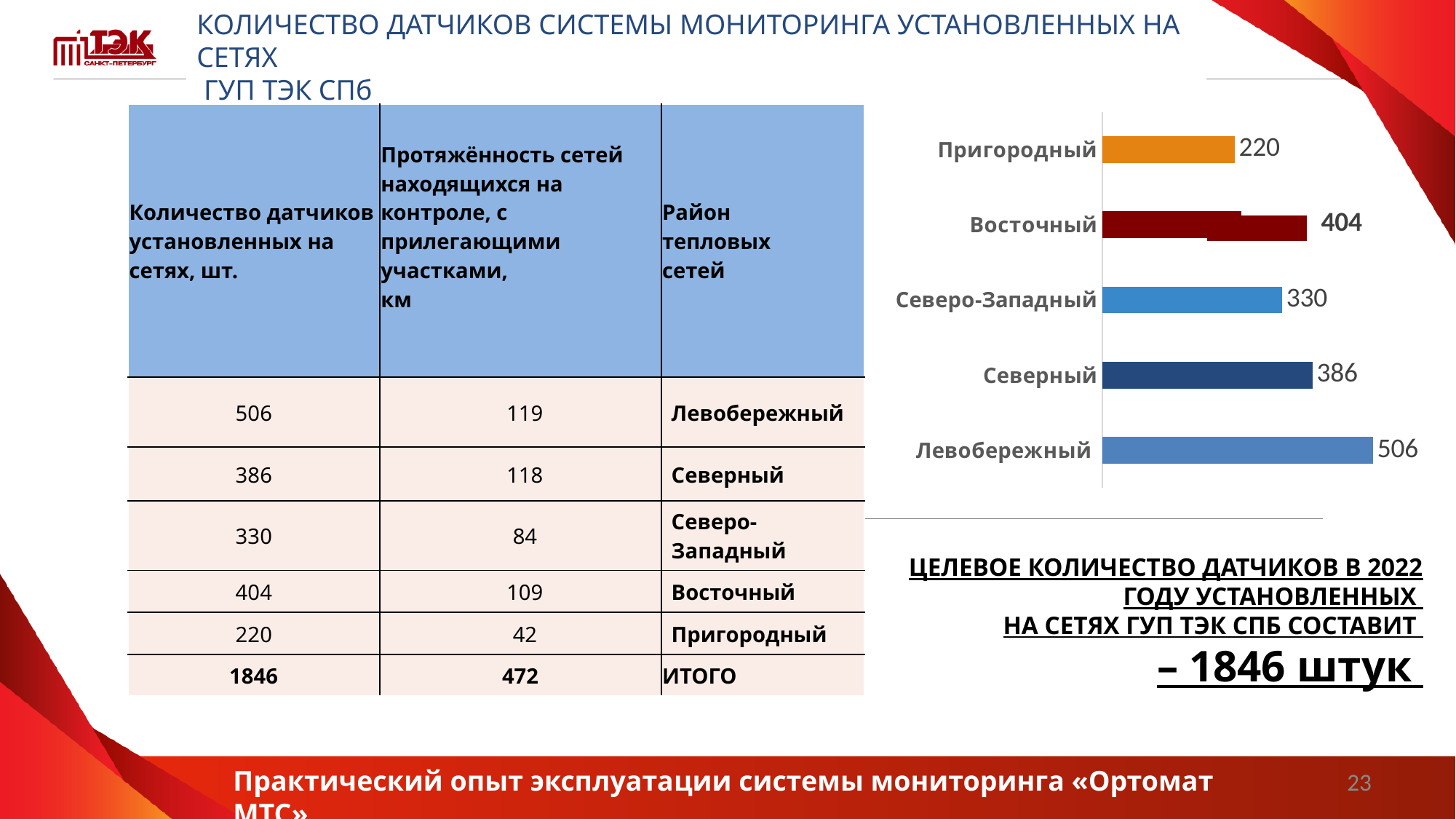
What is the value shown for Пригородный in the bar chart? 220 Which is larger in the bar chart, the value for Северный or the value for Северо-Западный? Северный What is the value shown for Северо-Западный in the bar chart? 330 What is the value shown for Левобережный in the bar chart? 506 What kind of chart is shown on the slide? Bar chart Which district has the highest value in the bar chart? Левобережный What is the difference between the values for Левобережный and Пригородный in the bar chart? 286 What is the value shown for Восточный in the bar chart? 404 Which district has the lowest value in the bar chart? Пригородный What is the value shown for Северный in the bar chart? 386 What is the difference between the values for Восточный and Северный in the bar chart? 18 How many districts are shown in the bar chart? 5